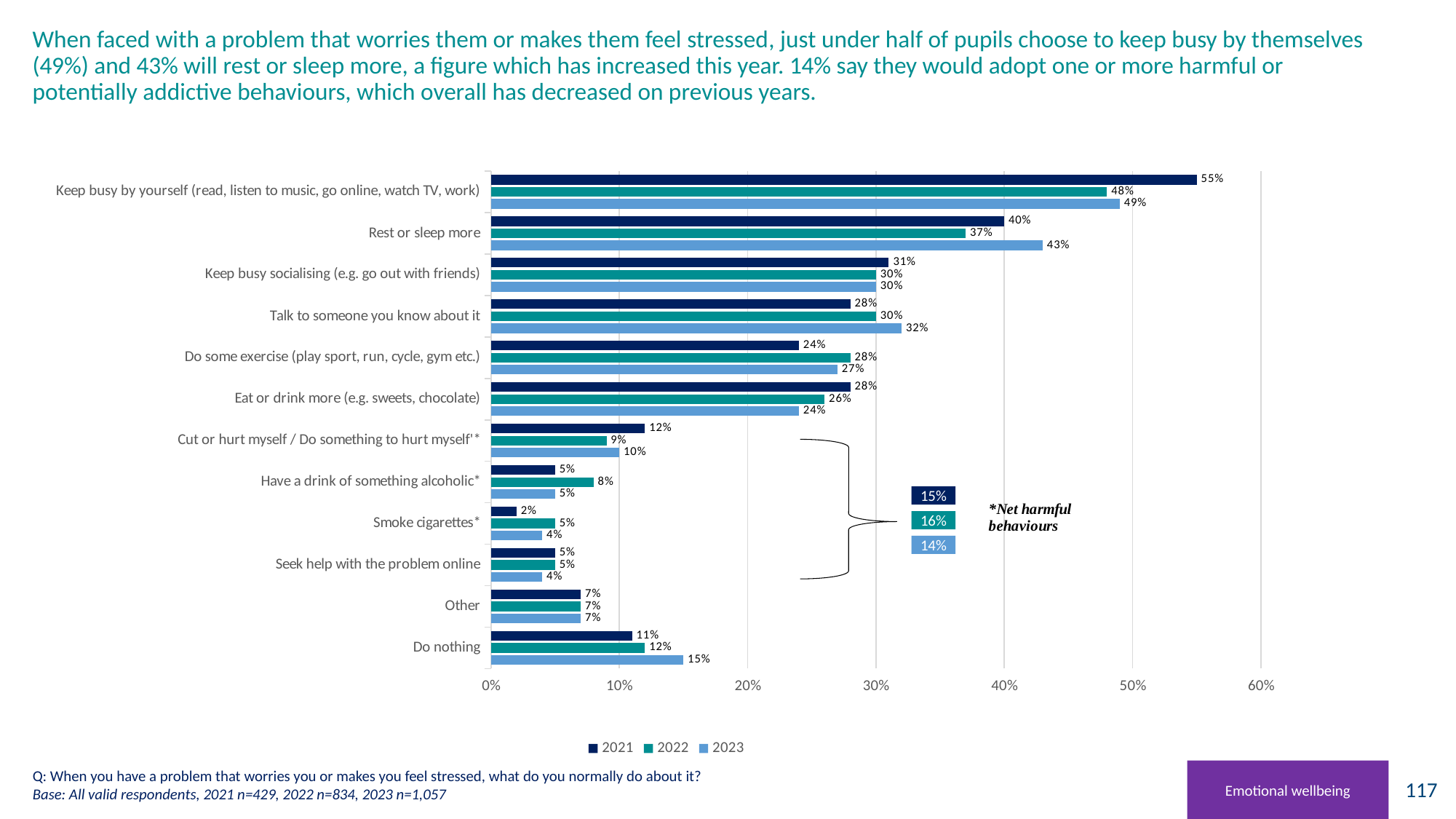
What is the 2023 net harmful behaviours value shown on the chart? 14% What is the difference between the 2023 and 2022 values for "Rest or sleep more"? 6% What is the 2022 value for "Have a drink of something alcoholic*"? 8% What are the three series listed in the legend? 2021, 2022, 2023 What is the 2023 value for "Rest or sleep more"? 43% Which is larger for "Do nothing": the 2021 value or the 2023 value? 2023 How many series does the legend list? 3 Which category has the highest 2023 value? Keep busy by yourself (read, listen to music, go online, watch TV, work) What is the 2021 value for "Keep busy by yourself (read, listen to music, go online, watch TV, work)"? 55% Which category has the lowest 2021 value? Smoke cigarettes* How many categories are shown on the chart? 12 What kind of chart is shown on the slide? Bar chart